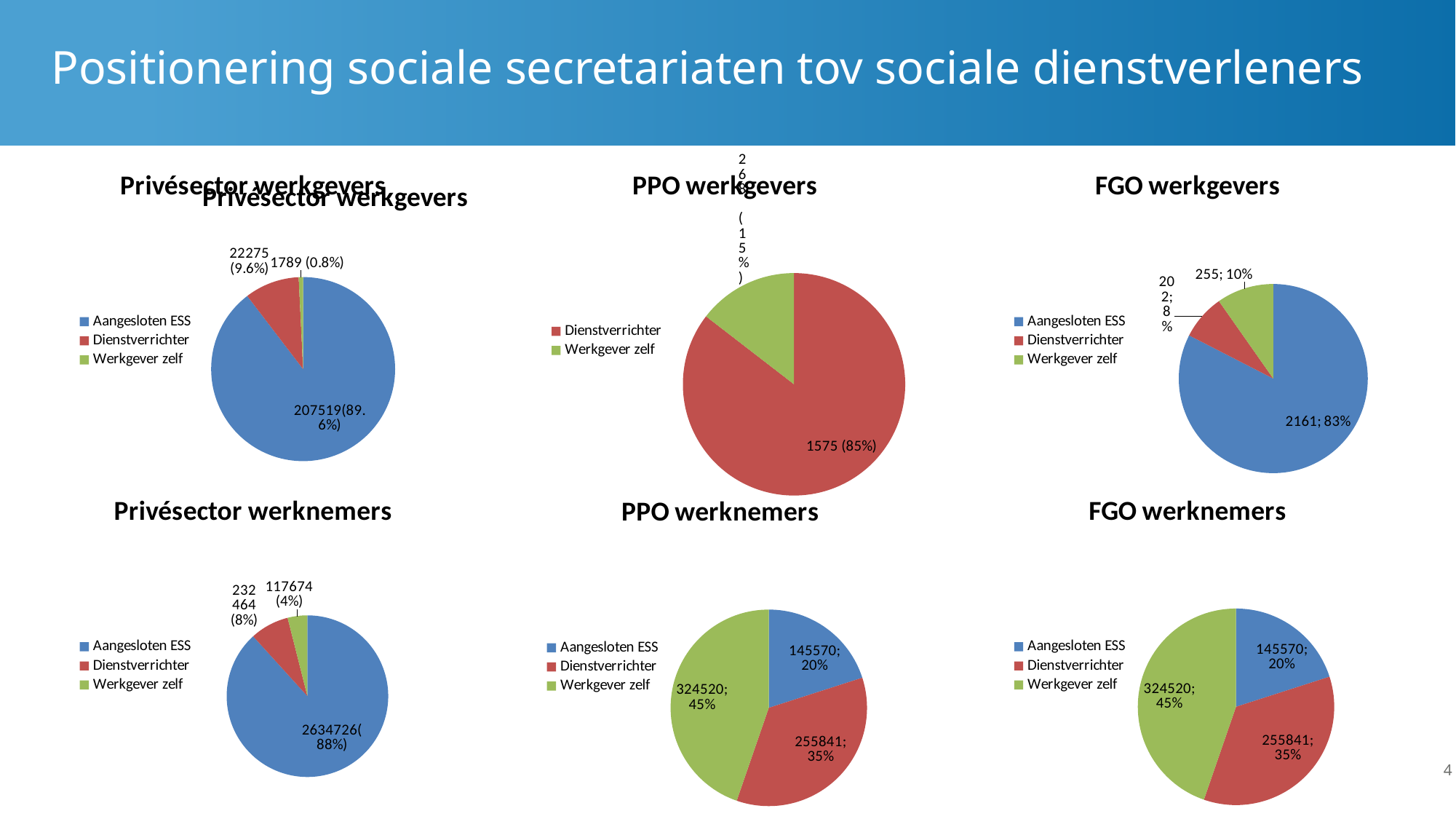
In the 'Privésector werkgevers' chart, what value is shown for Aangesloten ESS? 207519 (89.6%) How many entries does the legend of the 'PPO werkgevers' chart list? 2 What type of chart is 'FGO werknemers'? Pie chart In the 'FGO werkgevers' chart, what value is shown for Werkgever zelf? 255; 10% In the 'FGO werkgevers' chart, which is larger, Dienstverrichter or Werkgever zelf? Werkgever zelf In the 'Privésector werknemers' chart, what value is shown for Aangesloten ESS? 2634726 (88%) In the 'PPO werknemers' chart, what is the difference between the Dienstverrichter value and the Aangesloten ESS value? 110271 In the 'Privésector werkgevers' chart, which category has the smallest slice? Werkgever zelf In the 'FGO werkgevers' chart, what value is shown for Aangesloten ESS? 2161; 83% In the 'Privésector werkgevers' chart, what value is shown for Dienstverrichter? 22275 (9.6%) In the 'PPO werknemers' chart, which category has the largest slice? Werkgever zelf In the 'PPO werkgevers' chart, what value is shown for Dienstverrichter? 1575 (85%)